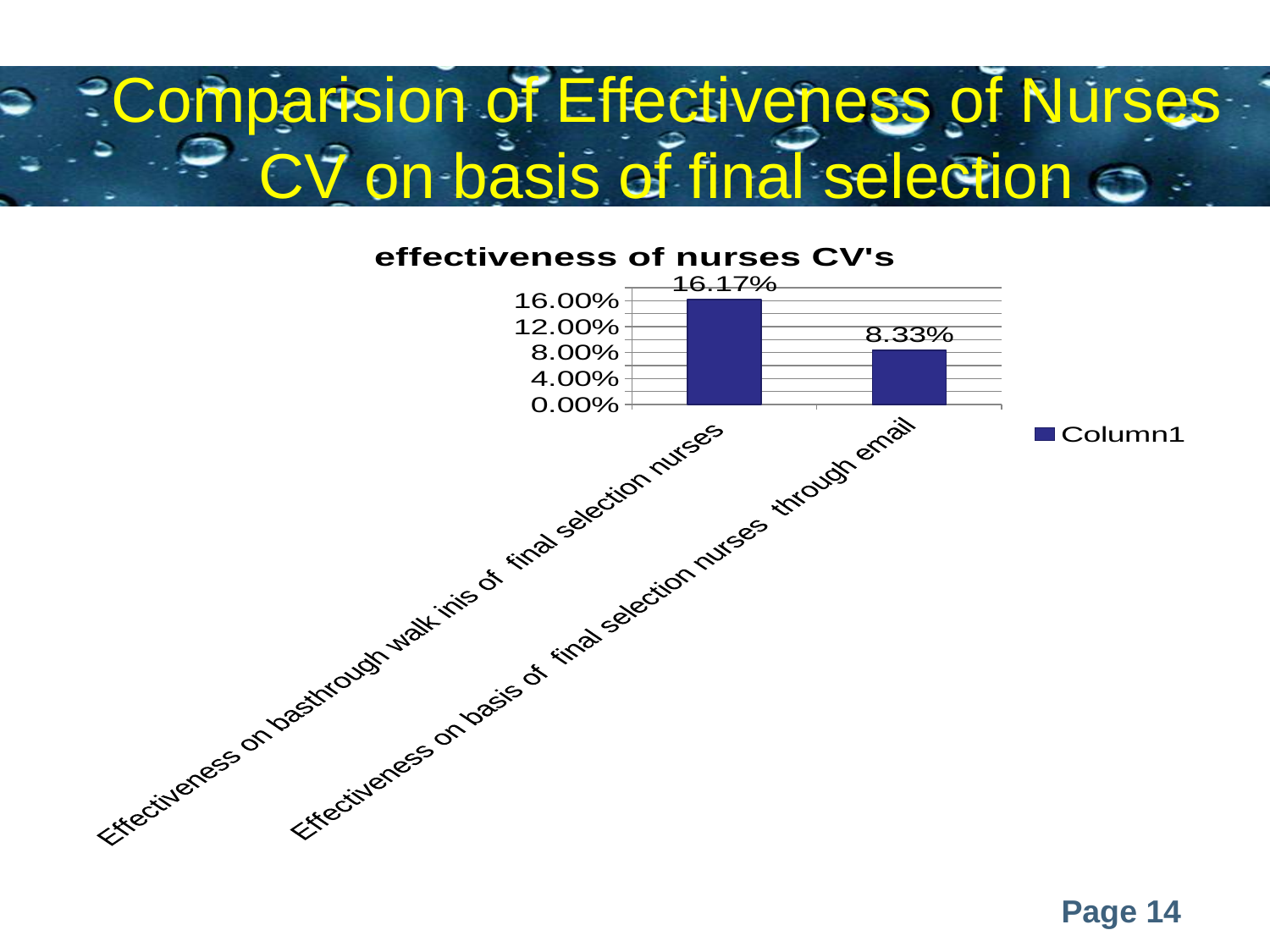
What is the difference between the walk-ins value and the email value? 7.84% What is the title of the chart? effectiveness of nurses CV's What kind of chart is shown on the slide? Bar chart What is the value for final selection nurses through email? 8.33% Which is larger, the value for walk-ins or the value for email? Walk-ins Which category has the highest value? Effectiveness on basthrough walk inis of final selection nurses How many series does the legend list? 1 Which category has the lowest value? Effectiveness on basis of final selection nurses through email Is the value for walk-ins greater or less than 12.00%? greater What is the value for the walk-ins category (final selection nurses through walk-ins)? 16.17% Is the value for final selection nurses through email greater or less than 12.00%? less How many categories are plotted in the chart? 2